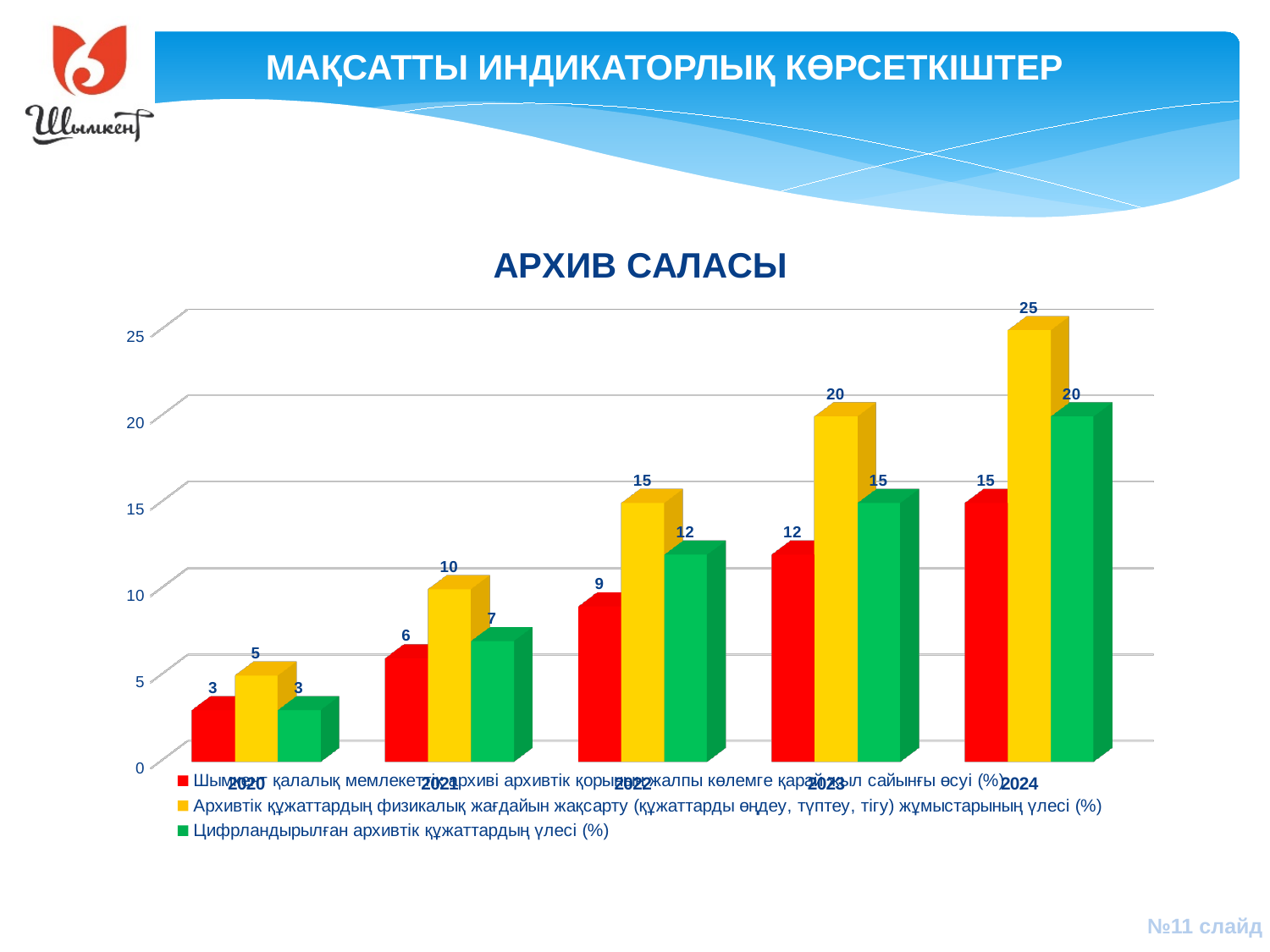
Do the values of the green series (Цифрландырылған архивтік құжаттардың үлесі) rise or fall from 2020 to 2024? rise What is the value of the green series (Цифрландырылған архивтік құжаттардың үлесі) in 2022? 12 What type of chart is shown on the slide? bar chart How many series does the legend list? 3 How many years are shown on the x axis? 5 In which year is the yellow series (Архивтік құжаттардың физикалық жағдайын жақсарту) highest? 2024 What is the value of the red series in 2023? 12 Which is larger in 2021: the yellow series or the red series? the yellow series What is the title of the chart? АРХИВ САЛАСЫ What is the value of the yellow series (Архивтік құжаттардың физикалық жағдайын жақсарту) in 2024? 25 In which year is the green series (Цифрландырылған архивтік құжаттардың үлесі) lowest? 2020 What is the difference between the yellow and green series values in 2023? 5